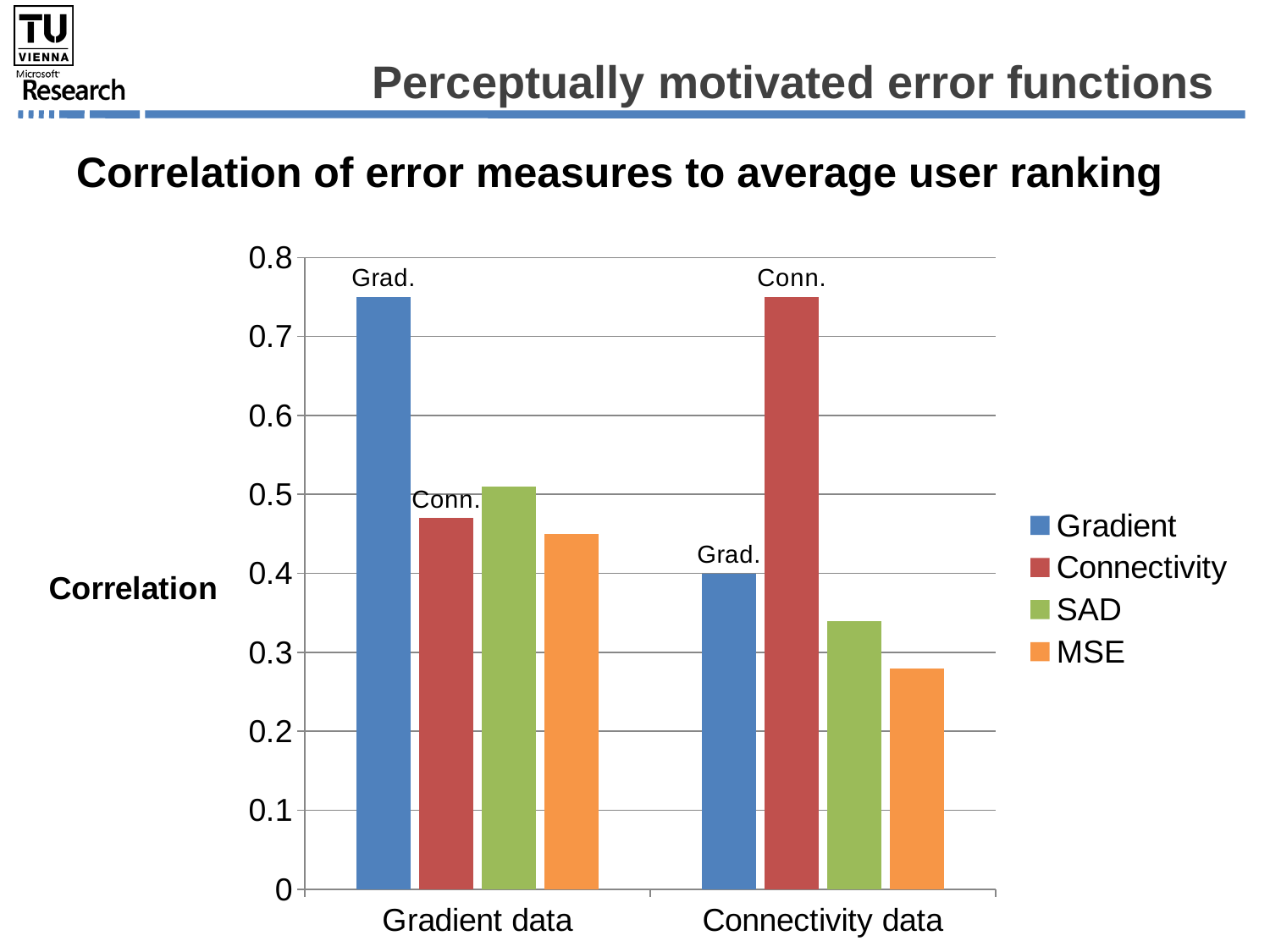
How many categories are shown on the x axis? 2 Which series has the highest correlation for Connectivity data? Connectivity Is the SAD value for Connectivity data greater or less than 0.4? less What is the title of the chart? Correlation of error measures to average user ranking How many series does the legend list? 4 Which series has the highest correlation for Gradient data? Gradient Which series has the lowest correlation for Connectivity data? MSE What kind of chart is shown on the slide? bar chart Is the MSE value for Connectivity data greater or less than 0.3? less For Gradient data, which is larger: the Gradient bar or the SAD bar? Gradient For Connectivity data, which is larger: the SAD bar or the MSE bar? SAD Is the Gradient value for Gradient data greater or less than 0.7? greater